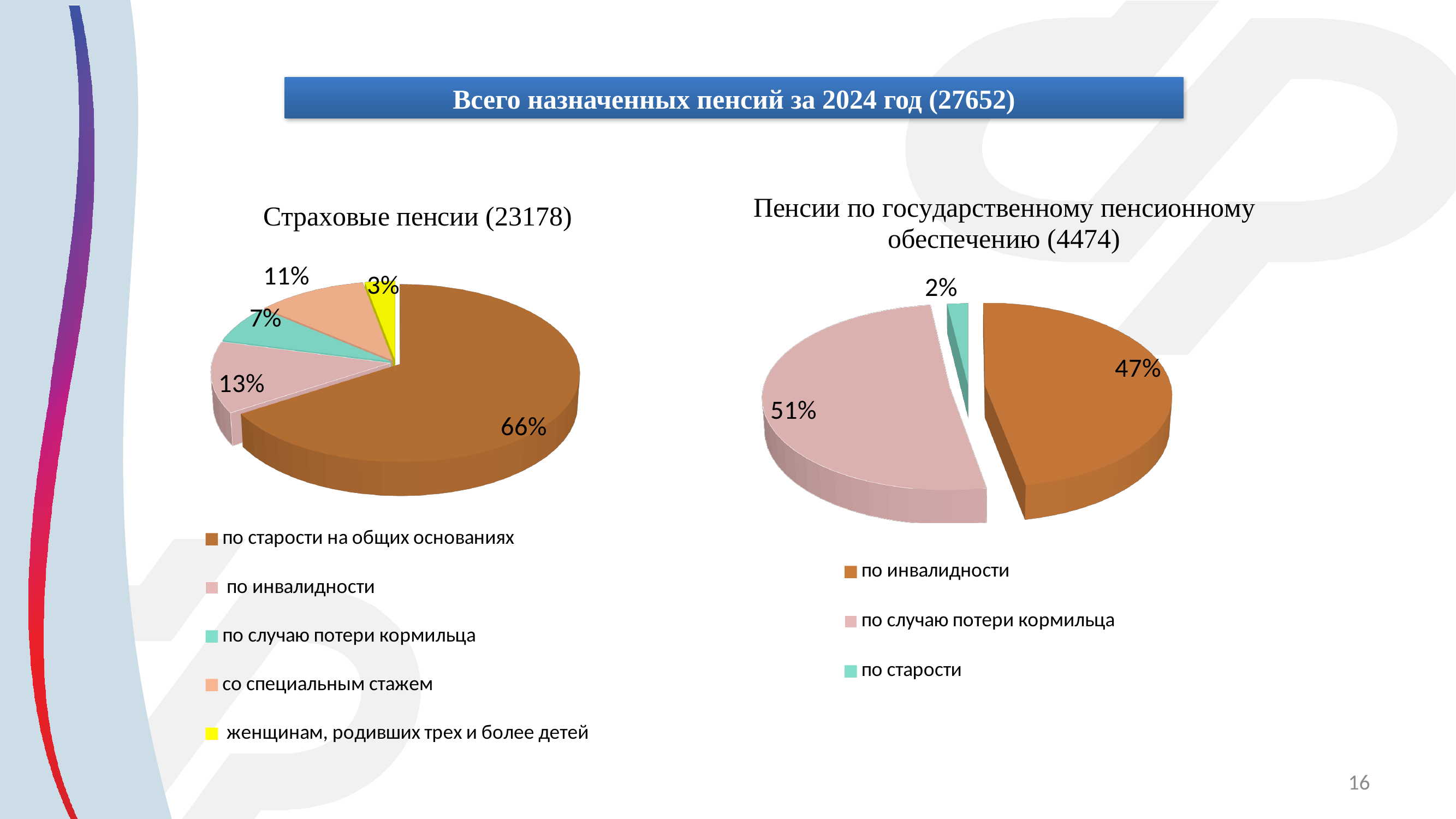
What type of chart is the one titled "Пенсии по государственному пенсионному обеспечению (4474)"? Pie chart In the chart titled "Пенсии по государственному пенсионному обеспечению (4474)", what share of the pie is "по старости"? 2% In the chart titled "Страховые пенсии (23178)", what is the difference between "по инвалидности" and "по случаю потери кормильца"? 6% In the chart titled "Страховые пенсии (23178)", which category has the smallest slice? женщинам, родивших трех и более детей In the chart titled "Страховые пенсии (23178)", what is the value for "со специальным стажем"? 11% In the chart titled "Пенсии по государственному пенсионному обеспечению (4474)", which category has the largest slice? по случаю потери кормильца In the chart titled "Страховые пенсии (23178)", how many slices does the pie have? 5 In the chart titled "Страховые пенсии (23178)", what share of the pie is "по старости на общих основаниях"? 66% In the chart titled "Пенсии по государственному пенсионному обеспечению (4474)", what is the value for "по случаю потери кормильца"? 51% In the chart titled "Страховые пенсии (23178)", what is the value for "по инвалидности"? 13% In the chart titled "Пенсии по государственному пенсионному обеспечению (4474)", how many categories does the legend list? 3 In the chart titled "Страховые пенсии (23178)", what colour is the slice for "женщинам, родивших трех и более детей"? Yellow